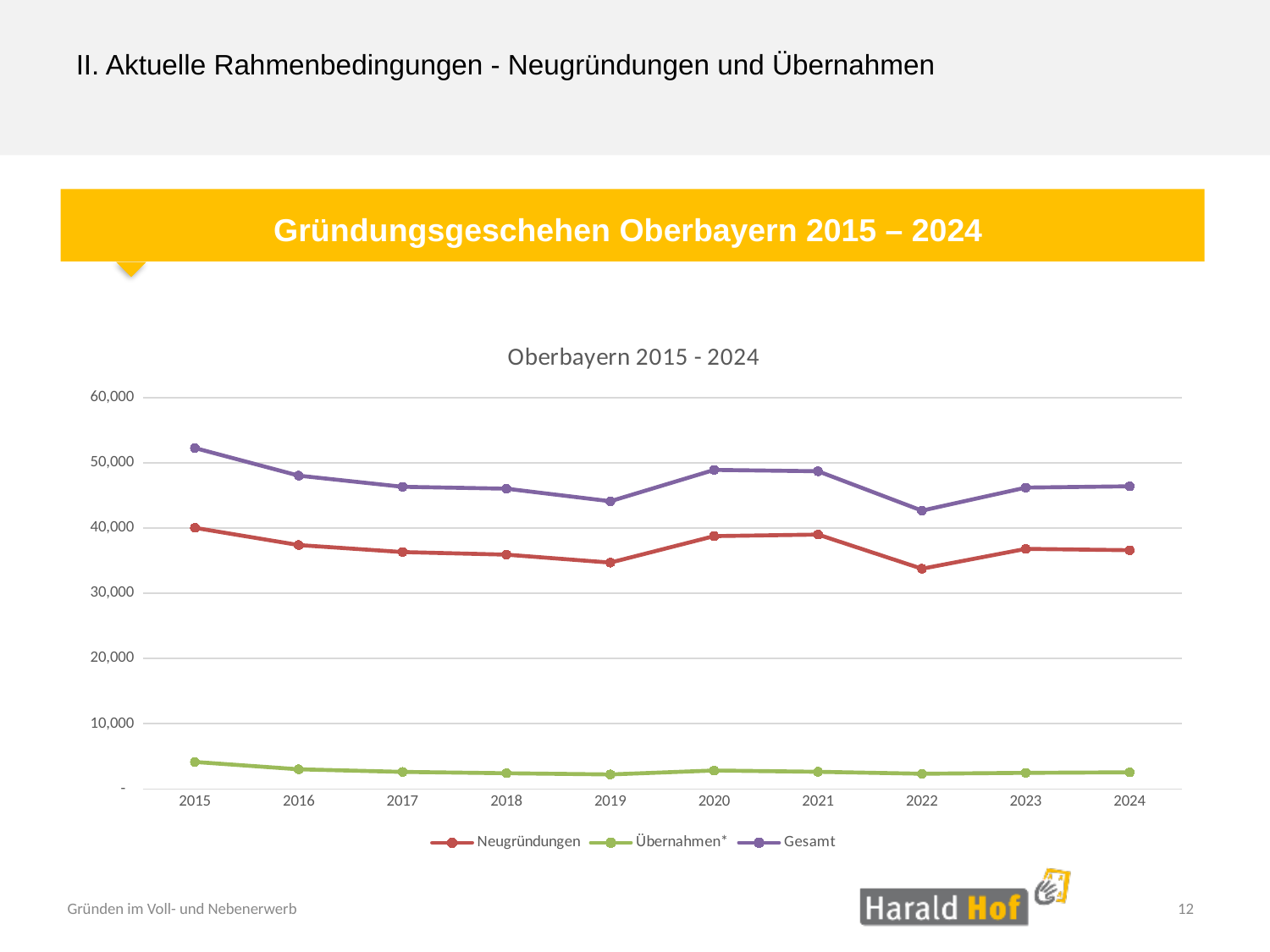
Is the value for Gesamt in 2015 greater or less than 50,000? greater How many years are plotted along the x axis? 10 In which year is the Gesamt series at its lowest? 2022 Which is larger, the Gesamt value in 2020 or the Gesamt value in 2022? 2020 What kind of chart is shown on the slide? line chart What is the title of the chart? Oberbayern 2015 - 2024 Is the value for Übernahmen* in 2019 greater or less than 10,000? less In which year is the Gesamt series at its highest? 2015 How many series does the legend list? 3 In which year is the Neugründungen series at its lowest? 2022 Is the value for Neugründungen in 2022 greater or less than 30,000? greater Does the Übernahmen* series rise or fall from 2015 to 2019? fall